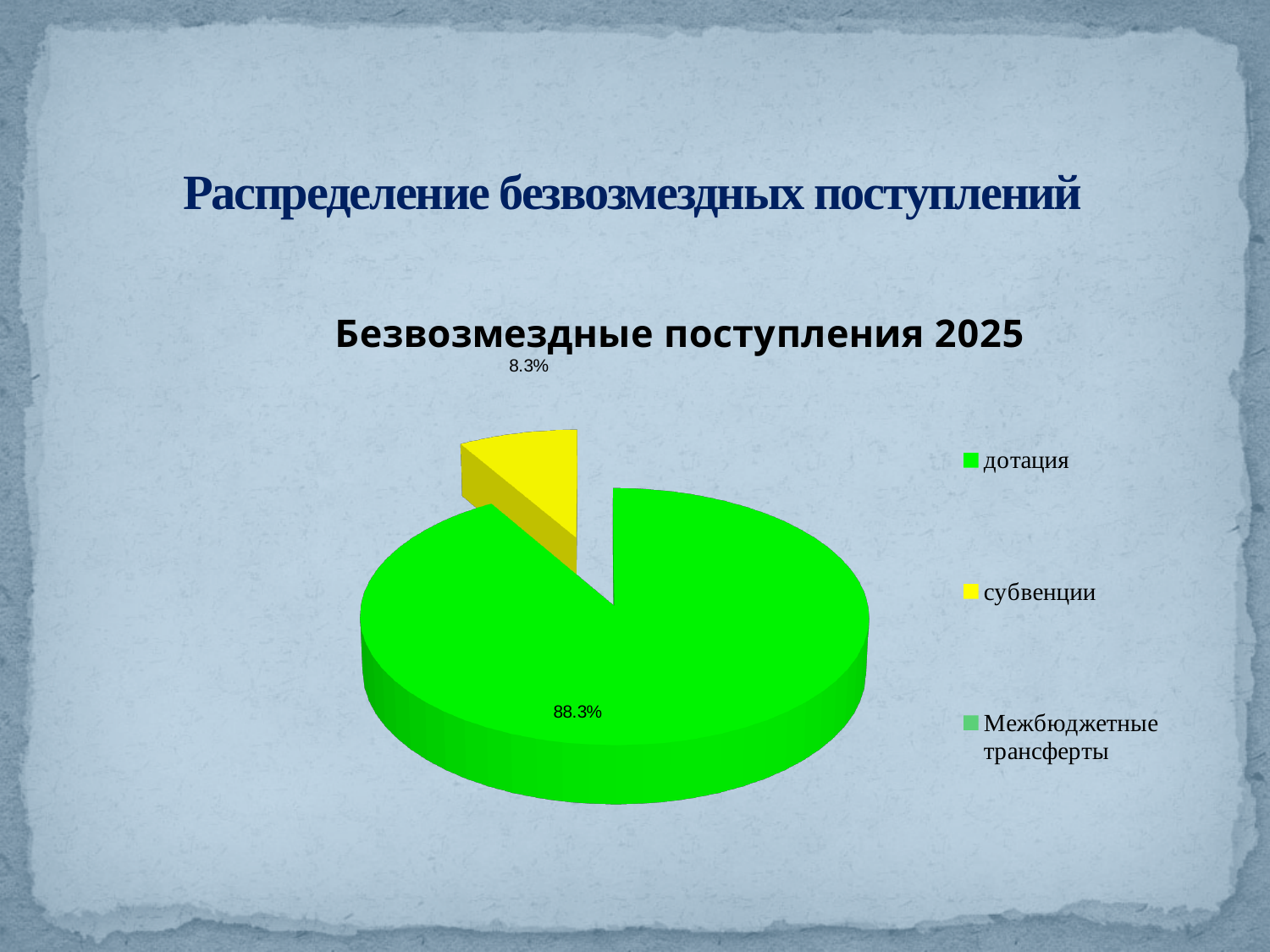
What colour is the slice for субвенции? yellow What is the value printed on the green slice? 88.3% What share of the pie does дотация account for? 88.3% By how many percentage points does the дотация share exceed the субвенции share? 80.0 percentage points What is the value printed on the yellow slice? 8.3% What share of the pie does субвенции account for? 8.3% How many entries does the legend list? 3 What kind of chart is shown on the slide? pie chart Which is larger, the slice for дотация or the slice for субвенции? дотация Which category has the largest slice of the pie? дотация What is the title of the chart? Безвозмездные поступления 2025